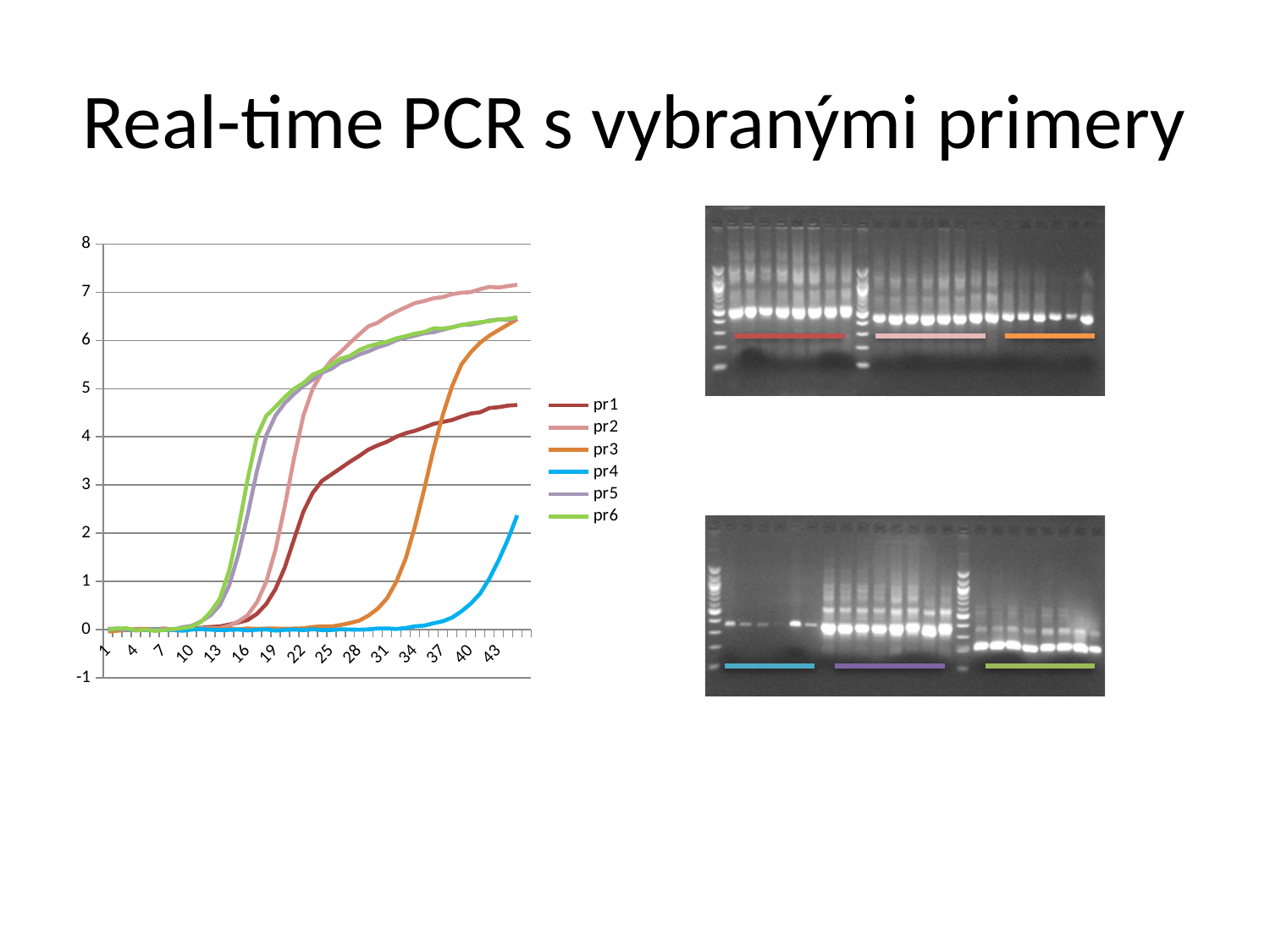
Which series in the line chart reaches the highest value at the right end of the x axis? pr2 How many series does the legend of the line chart list? 6 Is the final value of pr4 in the line chart greater or less than 3? less Do the values of pr2 in the line chart rise or fall along the x axis? rise At the right end of the line chart, which series is higher, pr1 or pr2? pr2 What are the names of the series listed in the legend of the line chart? pr1, pr2, pr3, pr4, pr5, pr6 Is the final value of pr3 in the line chart greater or less than 6? greater Is the final value of pr2 in the line chart greater or less than 6? greater Which series in the line chart starts rising latest along the x axis? pr4 What kind of chart is shown on the left of the slide? line chart Which series in the line chart has the lowest value at the right end of the x axis? pr4